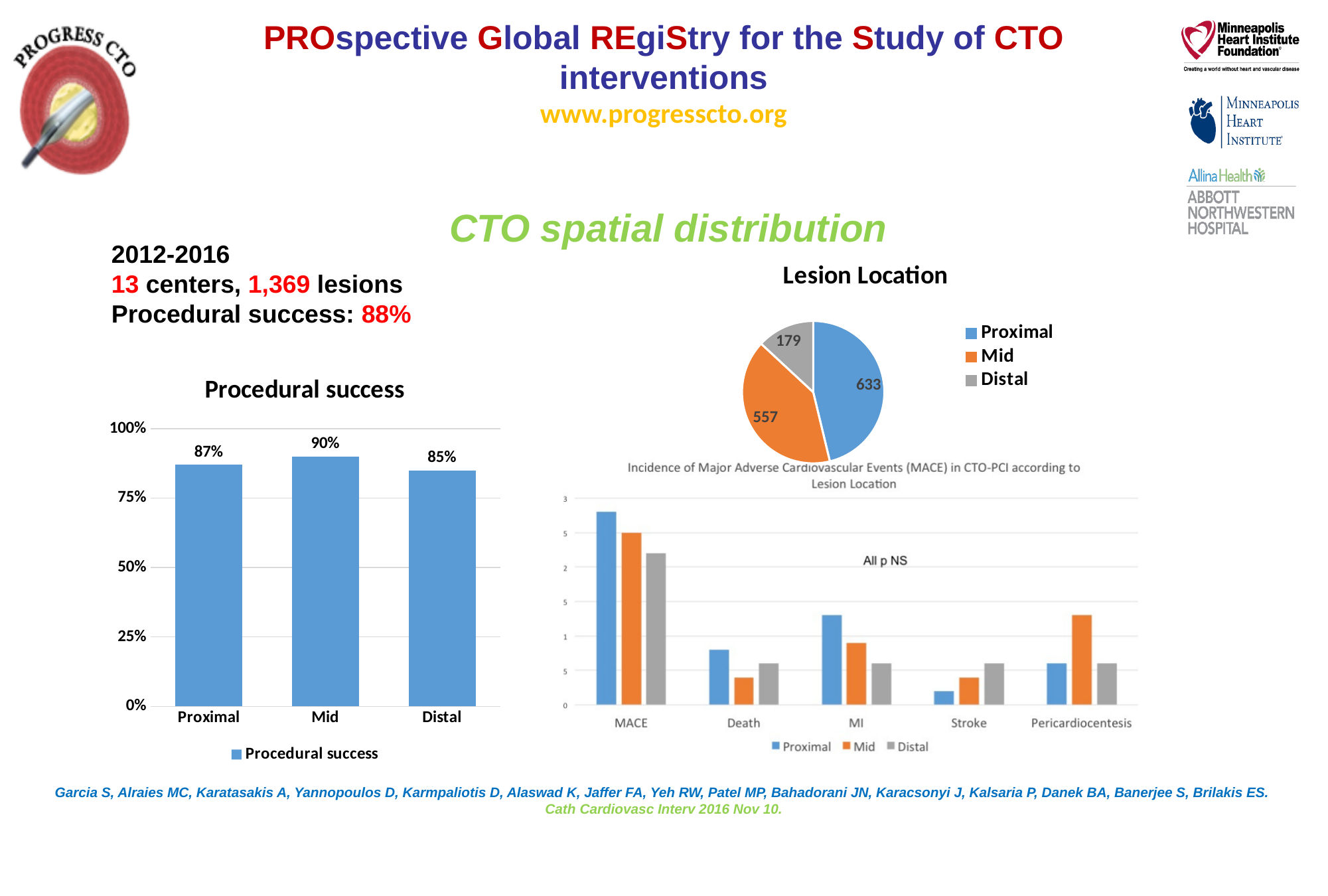
In the Procedural success chart, which lesion location has the highest procedural success? Mid In the Procedural success chart, what is the difference between the Mid and Distal success rates? 5% In the Lesion Location pie chart, how many lesions are Distal? 179 In the Procedural success chart, what is the procedural success rate for Distal lesions? 85% In the Lesion Location pie chart, how many lesions are Proximal? 633 In the MACE chart at the bottom right, how many event categories are shown on the x axis? 5 What kind of chart is the Procedural success chart? Bar chart In the Lesion Location pie chart, which location has the smallest slice? Distal In the Procedural success chart, what is the procedural success rate for Mid lesions? 90% In the Lesion Location pie chart, what is the total number of lesions across all three slices? 1,369 In the MACE chart at the bottom right, how many series does the legend list? 3 In the Procedural success chart, which lesion location has the lowest procedural success? Distal